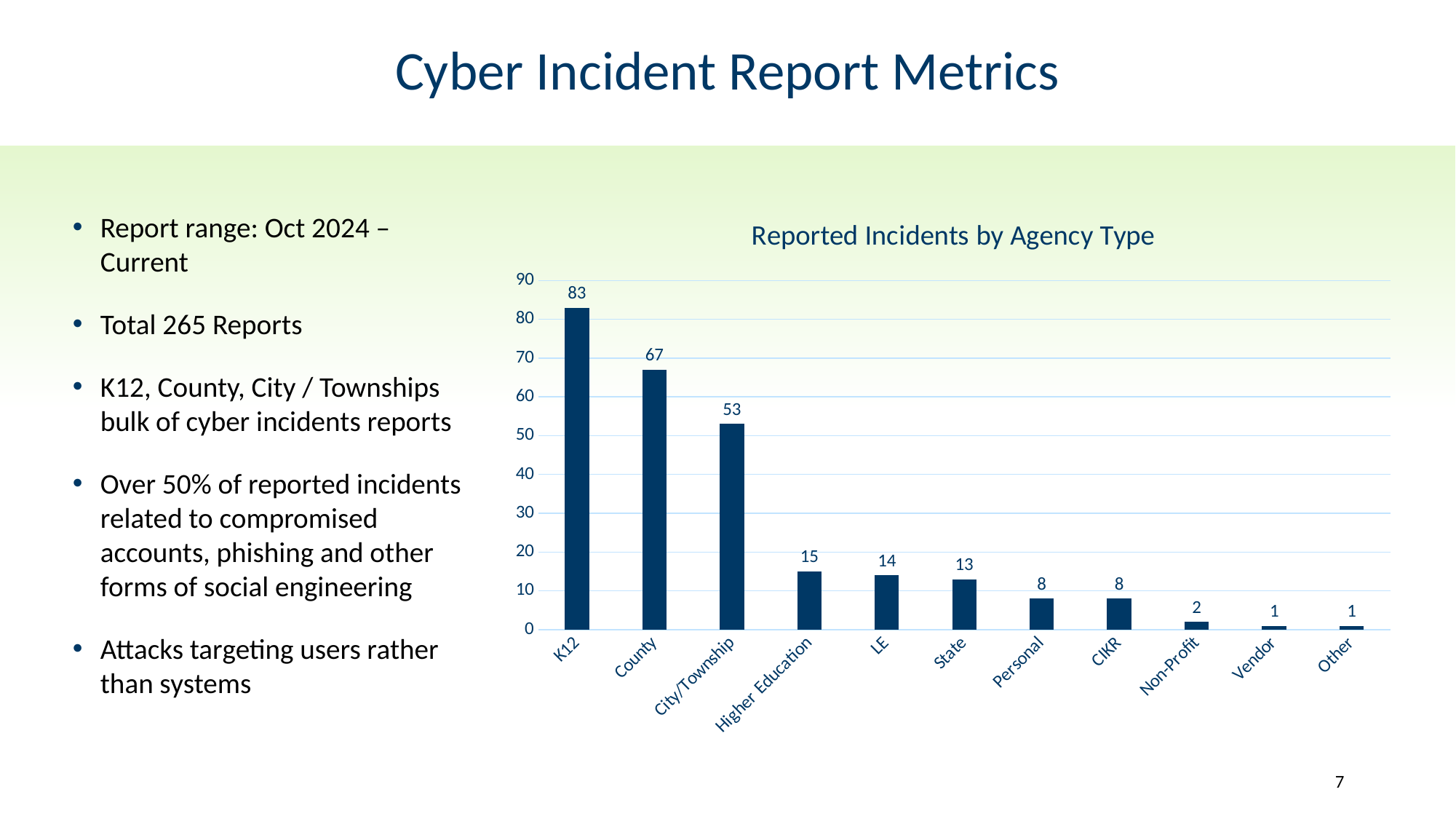
What is the value for K12 in the Reported Incidents by Agency Type chart? 83 Do the values rise or fall moving from left to right along the x axis? Fall What is the difference between the values for K12 and Higher Education? 68 What is the value for CIKR? 8 Which is larger, the value for LE or the value for State? LE What kind of chart is shown on the slide? Bar chart How many agency type categories are shown on the x axis? 11 What is the title of the chart? Reported Incidents by Agency Type Which agency type has the highest number of reported incidents? K12 Which agency type has the lowest value, Vendor or State? Vendor What is the difference between the values for County and City/Township? 14 How many reported incidents are shown for Higher Education? 15